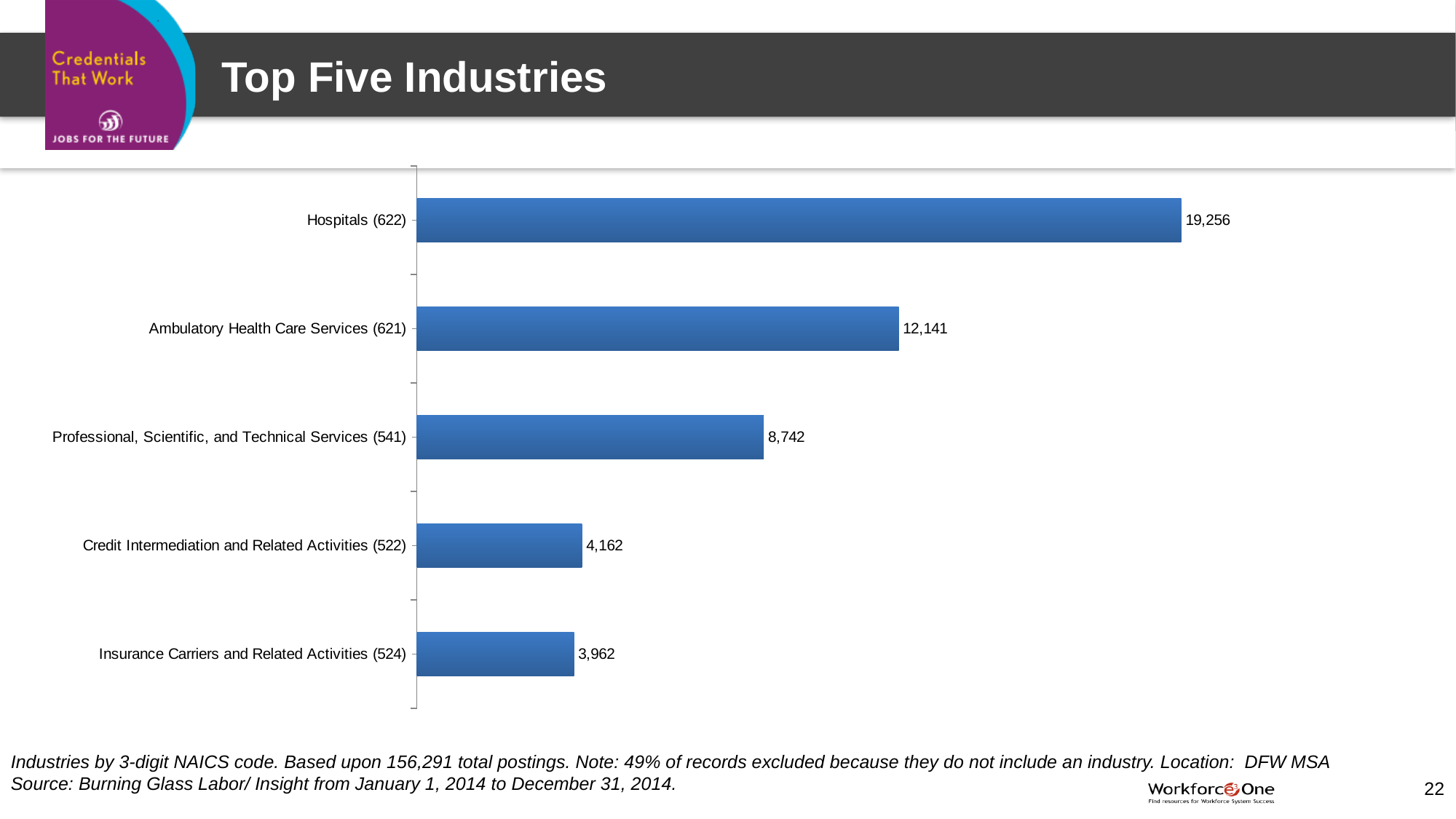
Which industry has the lowest value? Insurance Carriers and Related Activities (524) How many industries are shown in the chart? 5 What is the value for Ambulatory Health Care Services (621)? 12,141 What kind of chart is shown on the slide? Bar chart What is the value for Professional, Scientific, and Technical Services (541)? 8,742 What is the value for Credit Intermediation and Related Activities (522)? 4,162 What is the value for Insurance Carriers and Related Activities (524)? 3,962 Which is larger, the value for Credit Intermediation and Related Activities (522) or Insurance Carriers and Related Activities (524)? Credit Intermediation and Related Activities (522) What is the difference between the values for Hospitals (622) and Ambulatory Health Care Services (621)? 7,115 What is the title of the slide? Top Five Industries What is the value for Hospitals (622)? 19,256 Which industry has the highest value? Hospitals (622)